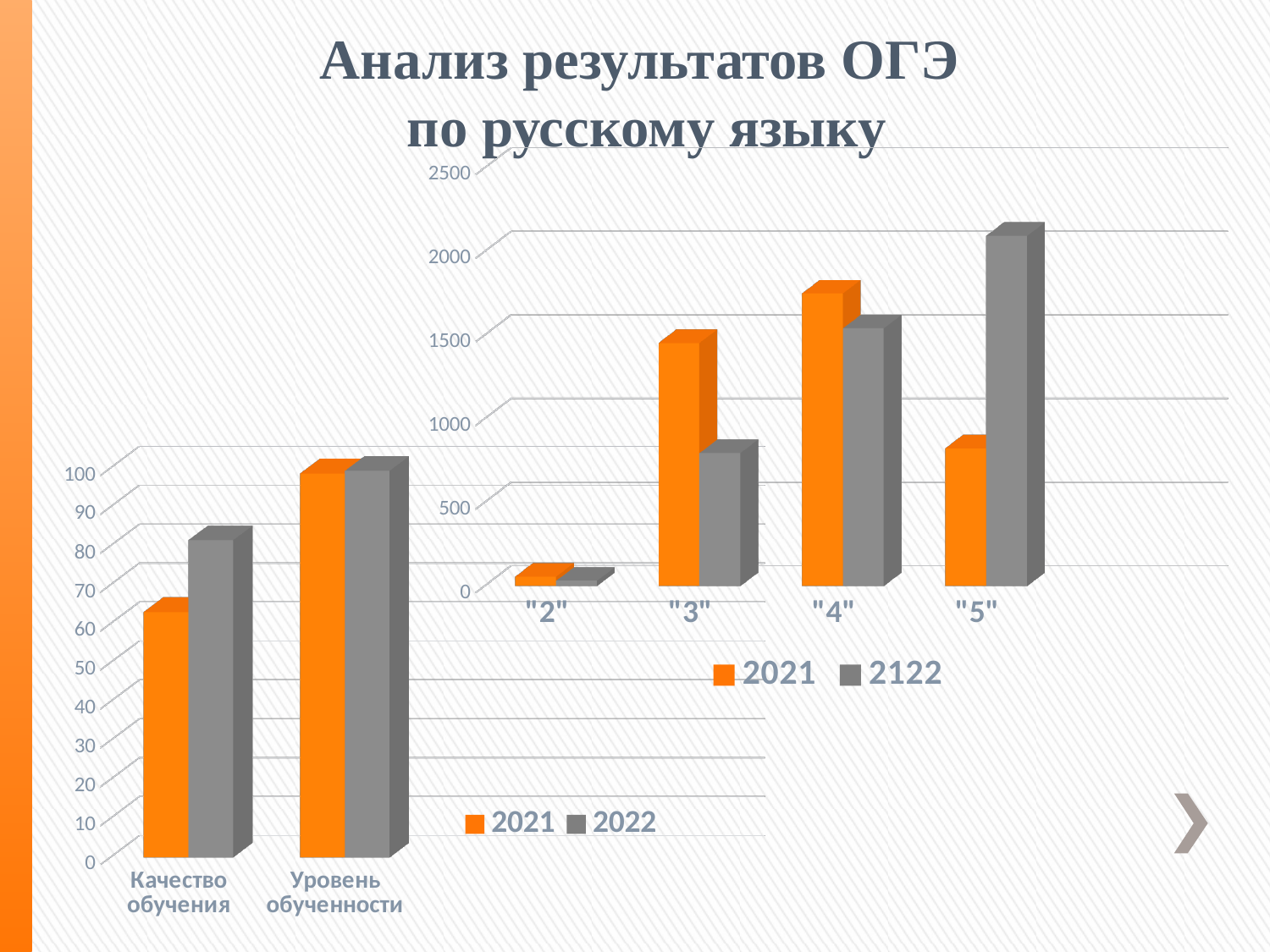
In the left chart, how many series does the legend list? 2 In the right chart, how many categories are shown on the x axis? 4 In the right chart, which category has the lowest 2021 value? "2" In the left chart, how many categories are shown on the x axis? 2 What kind of chart is the right chart? bar chart In the left chart, which series has the larger value for Качество обучения, 2021 or 2022? 2022 In the left chart, is the 2022 value for Качество обучения greater or less than 70? greater In the left chart, is the 2021 value for Качество обучения greater or less than 70? less In the right chart, what are the two legend entries? 2021 and 2122 In the right chart, is the 2021 value for "3" greater or less than 1000? greater In the right chart, which category has the highest 2122 value? "5" In the right chart, which series has the larger value for "4", 2021 or 2122? 2021